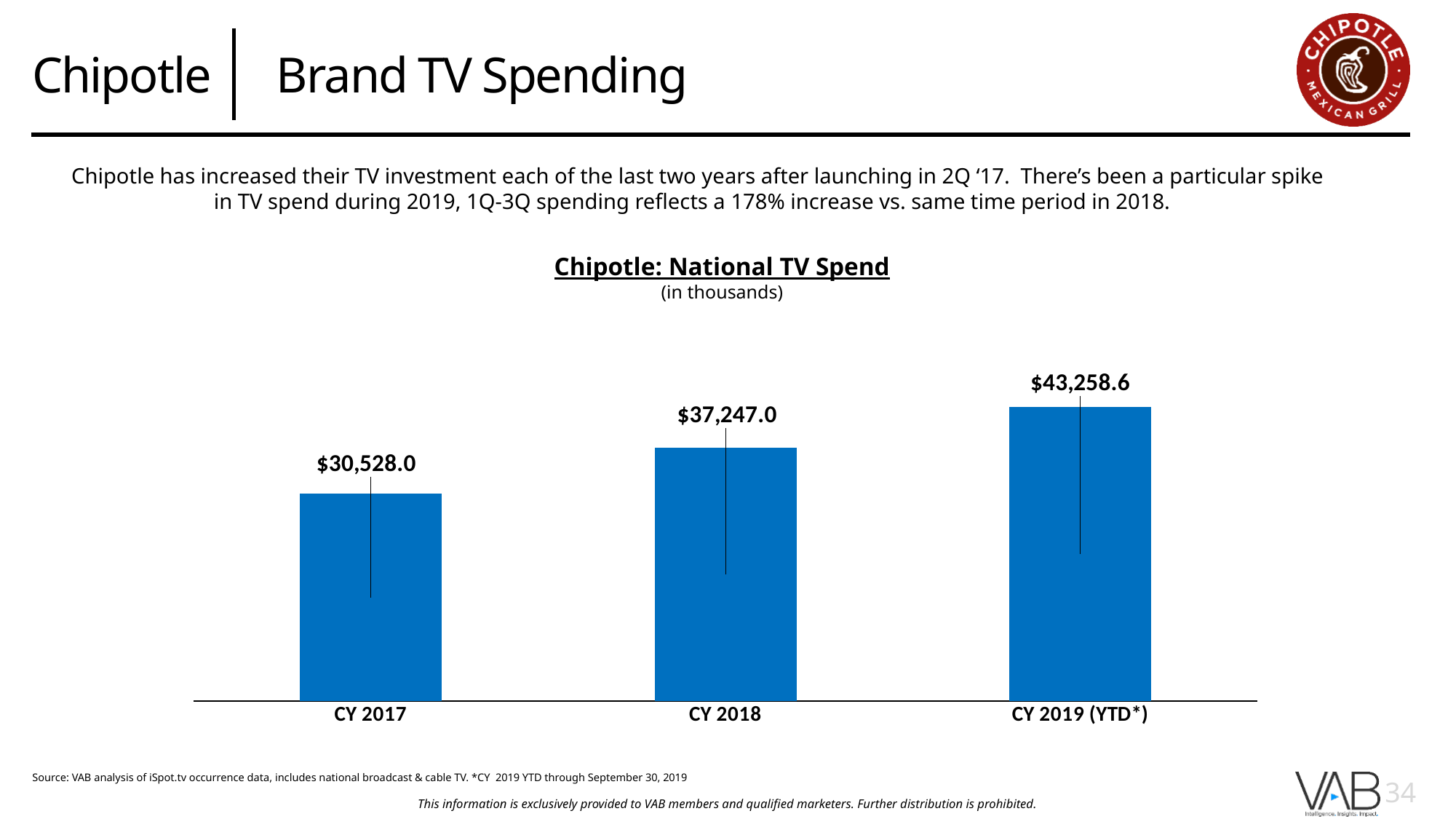
Which year has the highest national TV spend? CY 2019 (YTD*) What is the difference in national TV spend between CY 2018 and CY 2017? $6,719.0 What is the national TV spend for CY 2019 (YTD*)? $43,258.6 Which year has the lowest national TV spend? CY 2017 What is the national TV spend for CY 2018? $37,247.0 What is the national TV spend for CY 2017? $30,528.0 What is the difference in national TV spend between CY 2019 (YTD*) and CY 2018? $6,011.6 How many years are shown in the chart? 3 What kind of chart is shown on the slide? Bar chart What is the title of the chart? Chipotle: National TV Spend Which is larger, the TV spend for CY 2018 or CY 2019 (YTD*)? CY 2019 (YTD*) Do the national TV spend values rise or fall from CY 2017 to CY 2019 (YTD*)? Rise